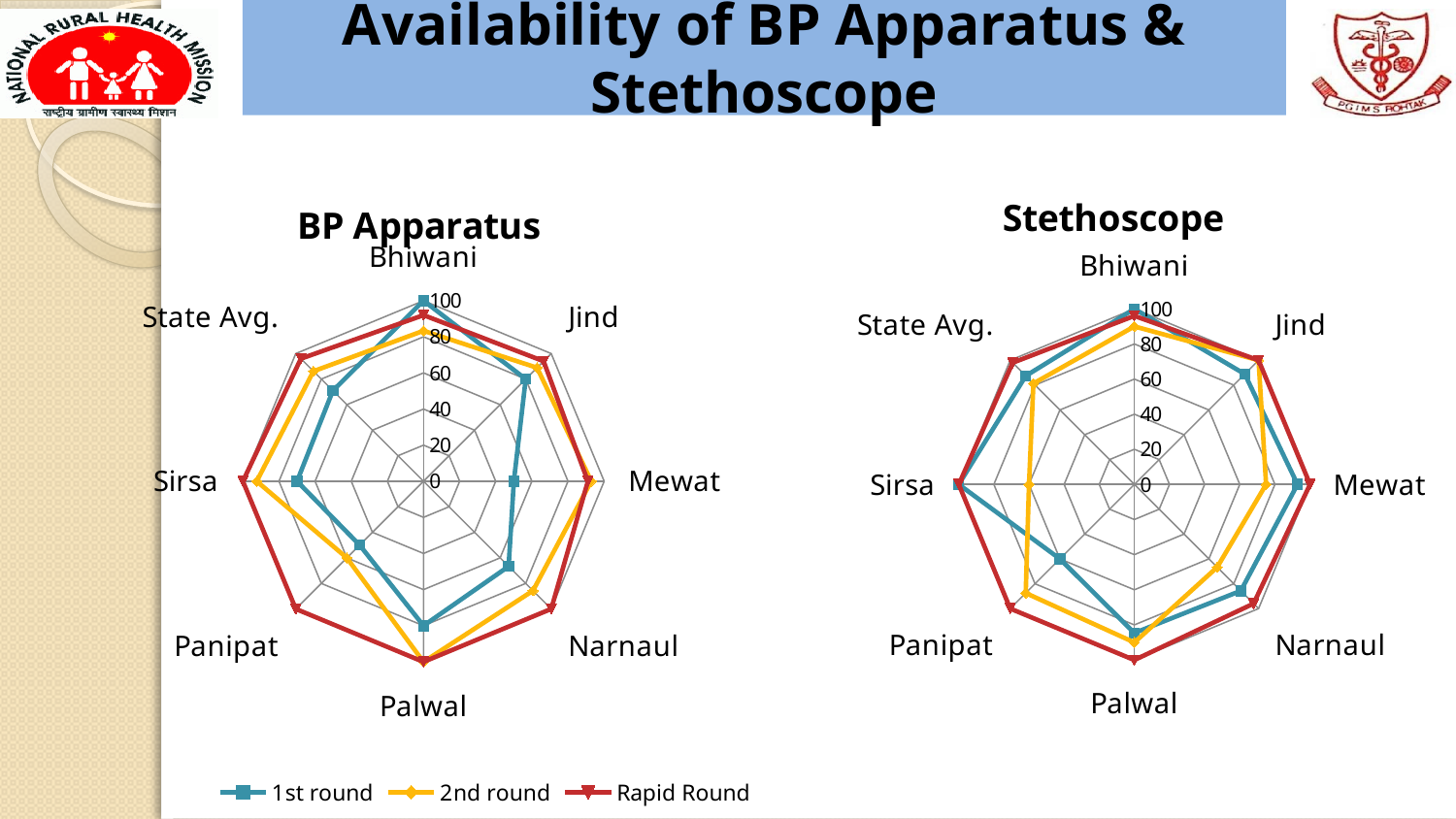
How many categories are plotted on the Stethoscope chart? 8 On the BP Apparatus chart, is the 1st round value for Panipat greater or less than 80? less What kind of chart is the BP Apparatus chart? Radar chart On the Stethoscope chart, is the 1st round value for Panipat greater or less than 80? less On the BP Apparatus chart, is the 1st round value for Mewat greater or less than 60? less What are the three series named in the legend? 1st round, 2nd round, Rapid Round How many series does the legend list for the charts on this slide? 3 What is the title of the chart on the right side of the slide? Stethoscope